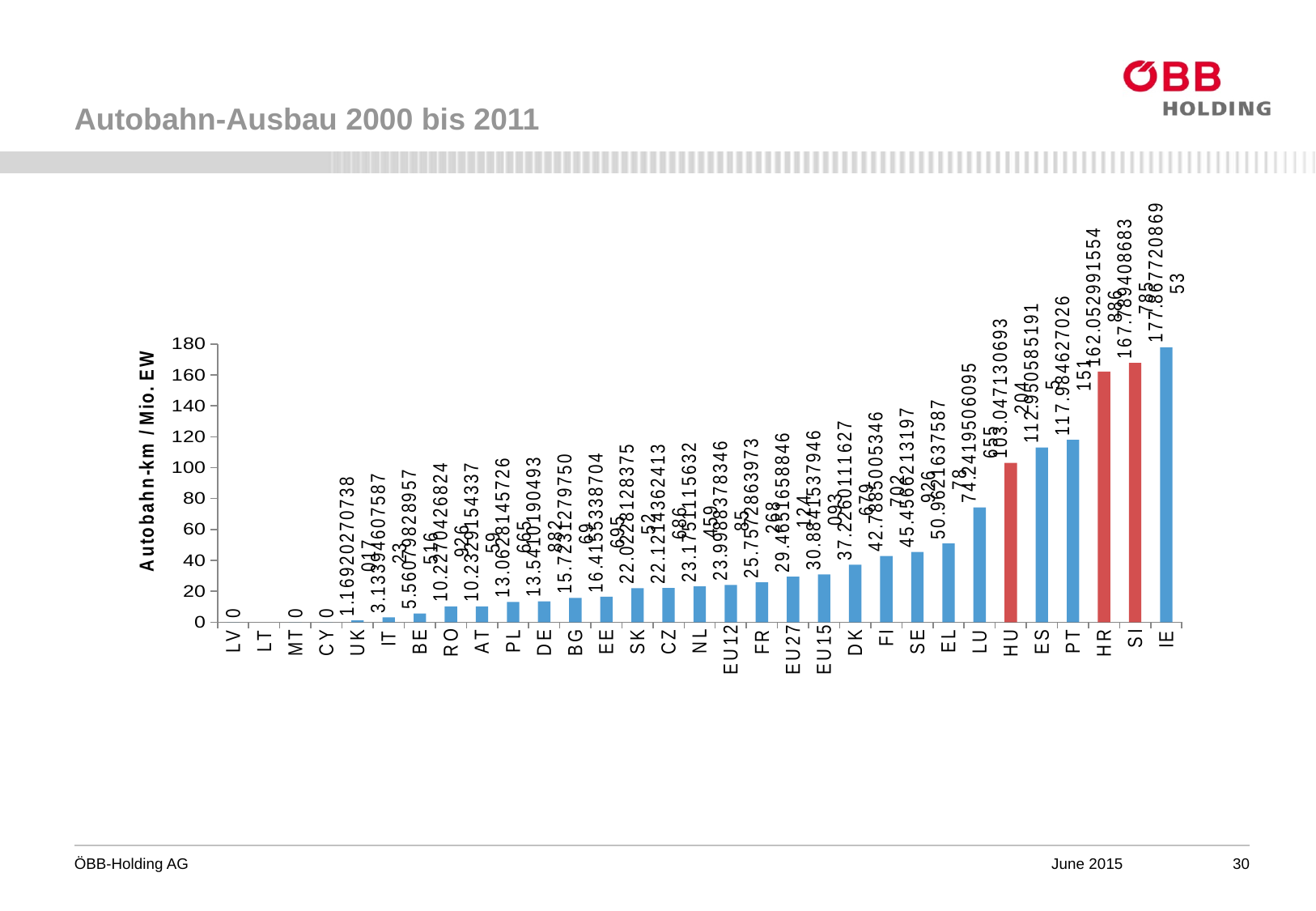
Is the value for LU greater or less than 80? less Is the value for SE greater or less than 60? less How many categories are shown on the x axis of the chart? 31 Which is larger, the value for HR or the value for HU? HR Which category has the highest value in the chart? IE Do the values generally rise or fall from left to right along the x axis? rise Is the value for HU greater or less than 100? greater What is the label of the y axis of the chart? Autobahn-km / Mio. EW What kind of chart is shown on the slide? bar chart Which categories are drawn with red bars in the chart? HU, HR, SI